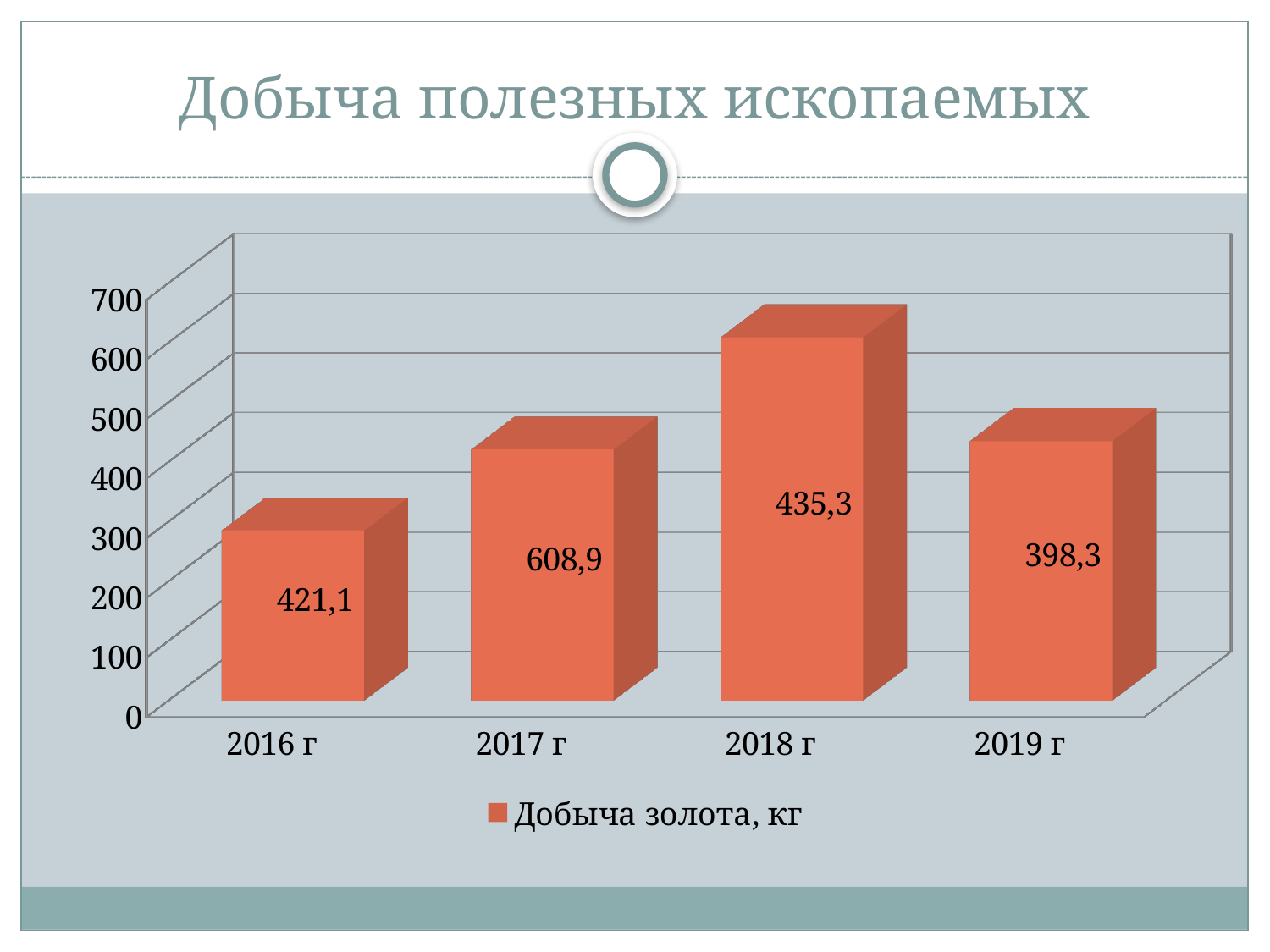
What is the value for 2017 г? 608,9 What is the difference between the values for 2017 г and 2016 г? 187,8 What is the value for 2019 г? 398,3 What is the difference between the values for 2017 г and 2018 г? 173,6 What kind of chart is shown on the slide? bar chart What is the title of the slide? Добыча полезных ископаемых What is the legend entry of the series? Добыча золота, кг How many categories are shown on the x axis? 4 What is the value for 2018 г? 435,3 What is the difference between the values for 2018 г and 2019 г? 37 What is the value for 2016 г? 421,1 How many series does the legend list? 1